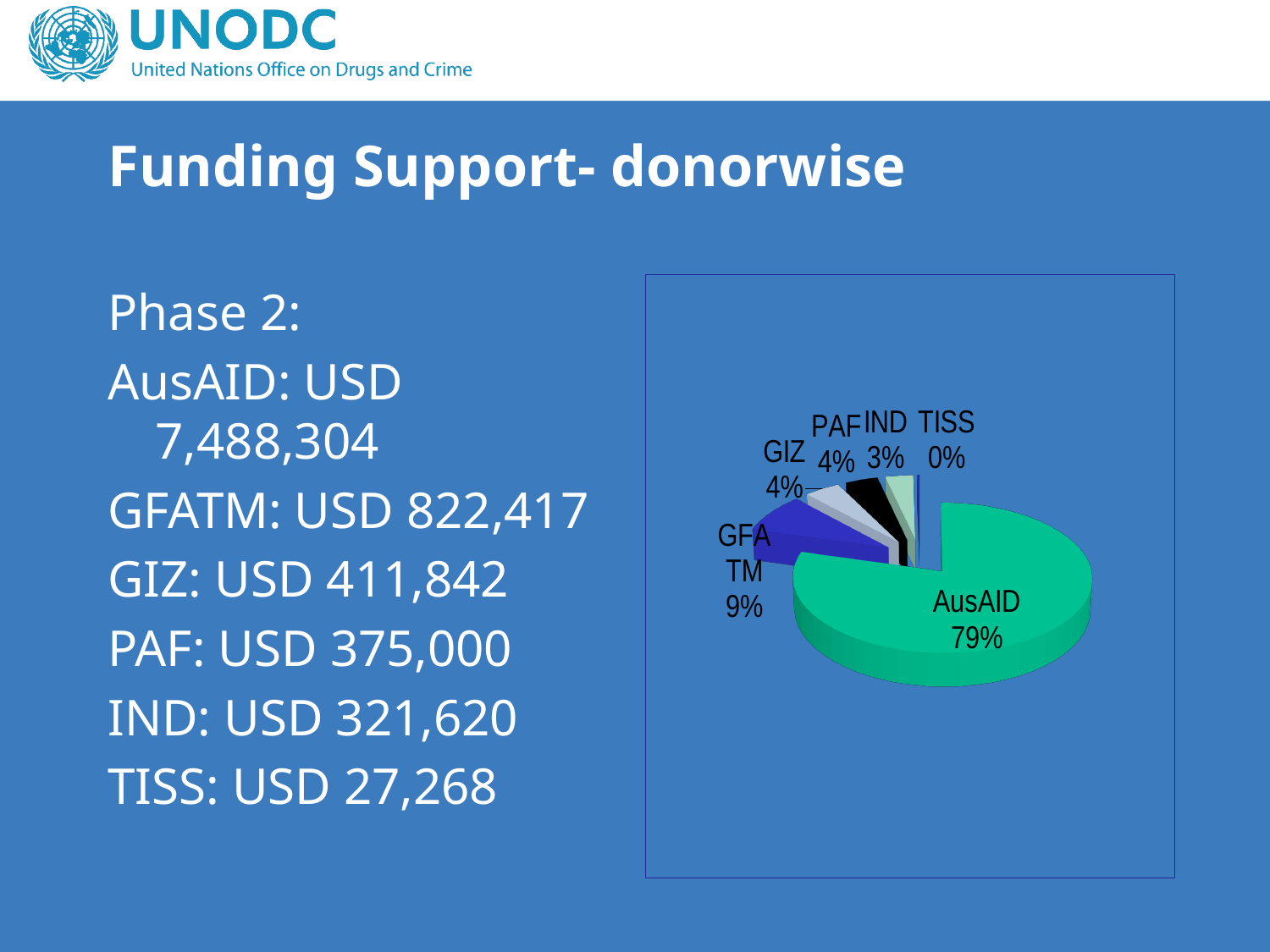
What share of the pie does GIZ have? 4% What share of the pie does AusAID have? 79% How many slices does the pie chart have? 6 What share of the pie does TISS have? 0% What is the difference in percentage points between the AusAID slice and the GFATM slice? 70 What kind of chart is shown on the slide? pie chart What colour is the AusAID slice? green Which donor has the largest slice of the pie? AusAID Which slice is larger, GFATM or IND? GFATM Which donor has the smallest slice of the pie? TISS